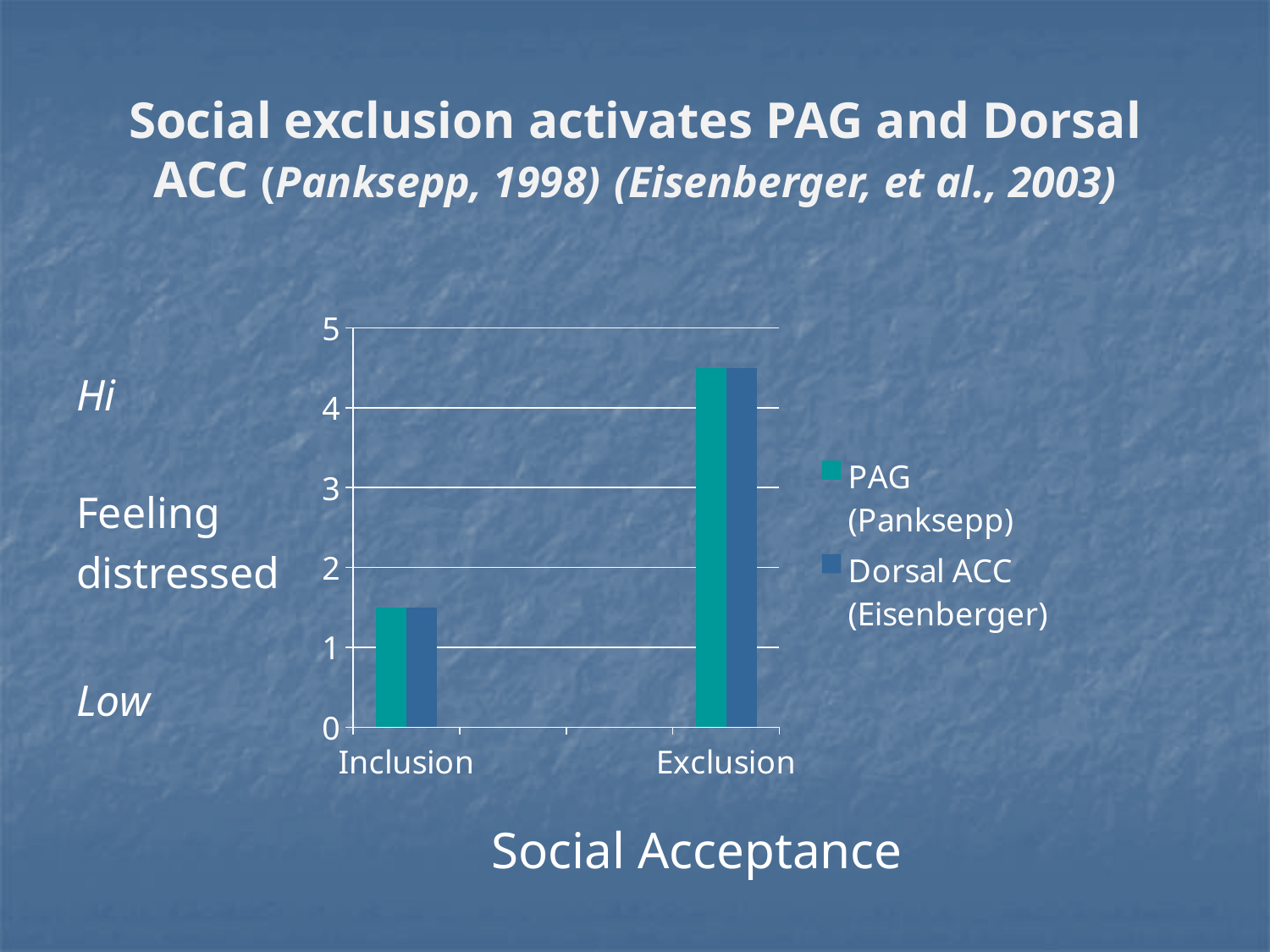
For the PAG (Panksepp) series, which is larger: Inclusion or Exclusion? Exclusion Which category has the lowest value for the Dorsal ACC (Eisenberger) series? Inclusion What kind of chart is shown on the slide? bar chart Which category has the highest value for the PAG (Panksepp) series? Exclusion Is the PAG (Panksepp) value for Inclusion greater or less than 2? less How many series does the chart's legend list? 2 What is the title of the chart's x axis? Social Acceptance How many categories are shown on the x axis of the chart? 2 Is the Dorsal ACC (Eisenberger) value for Exclusion greater or less than 4? greater What are the two entries listed in the chart's legend? PAG (Panksepp) and Dorsal ACC (Eisenberger) Is the Dorsal ACC (Eisenberger) value for Inclusion greater or less than 1? greater Do the values rise or fall from Inclusion to Exclusion? rise